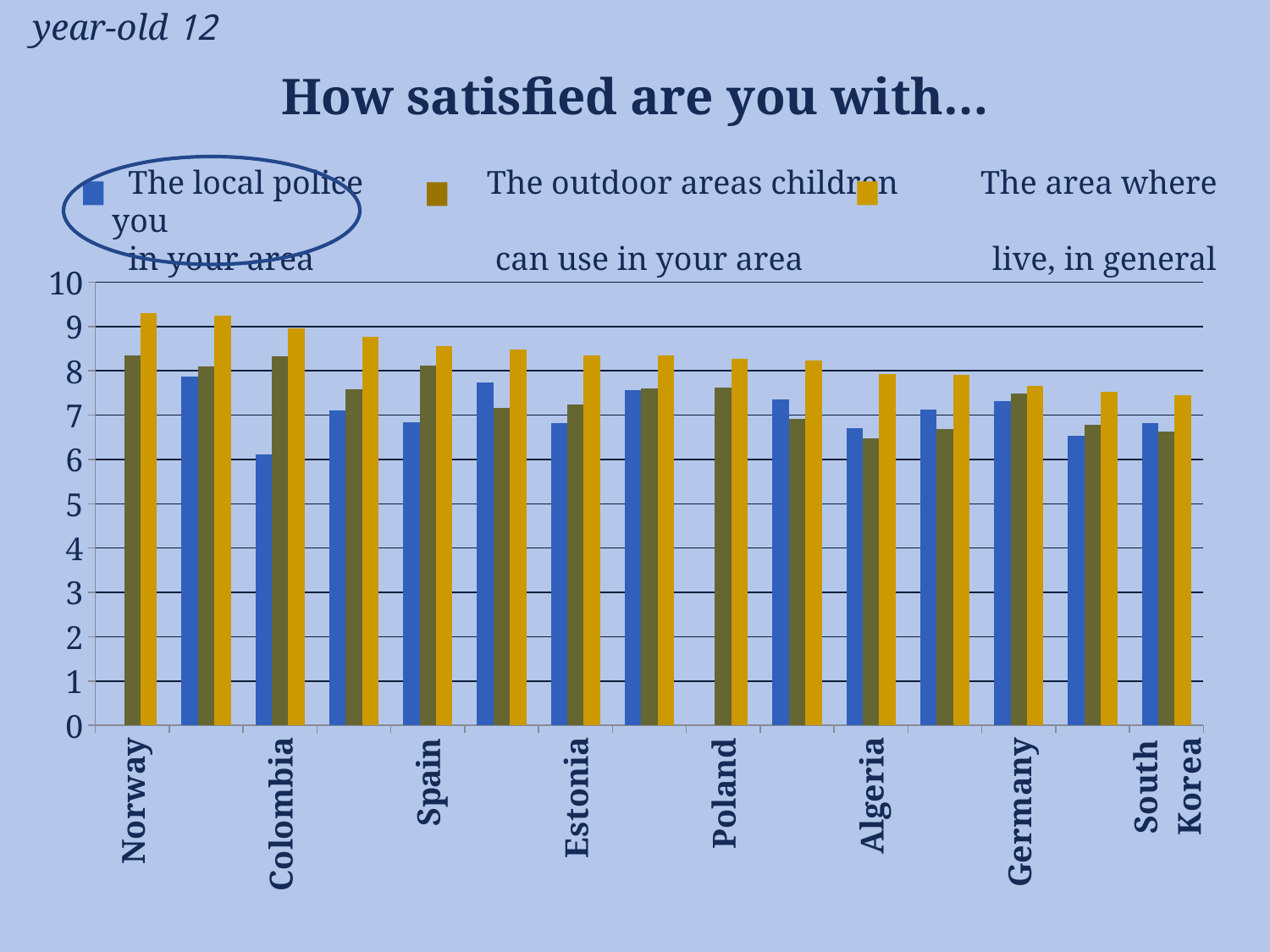
What kind of chart is shown on the slide? bar chart For Colombia, which is larger: 'The local police in your area' or 'The area where you live, in general'? The area where you live, in general Is the value for 'The outdoor areas children can use in your area' for South Korea greater or less than 7? less Is the value for 'The local police in your area' for Colombia greater or less than 7? less How many series does the legend list? 3 Is the value for 'The area where you live, in general' for Germany greater or less than 8? less What is the title of the chart? How satisfied are you with... Which legend entry is circled on the slide? The local police in your area Do the values for 'The area where you live, in general' generally rise or fall from Norway to South Korea? fall Which series has the highest value for Estonia? The area where you live, in general